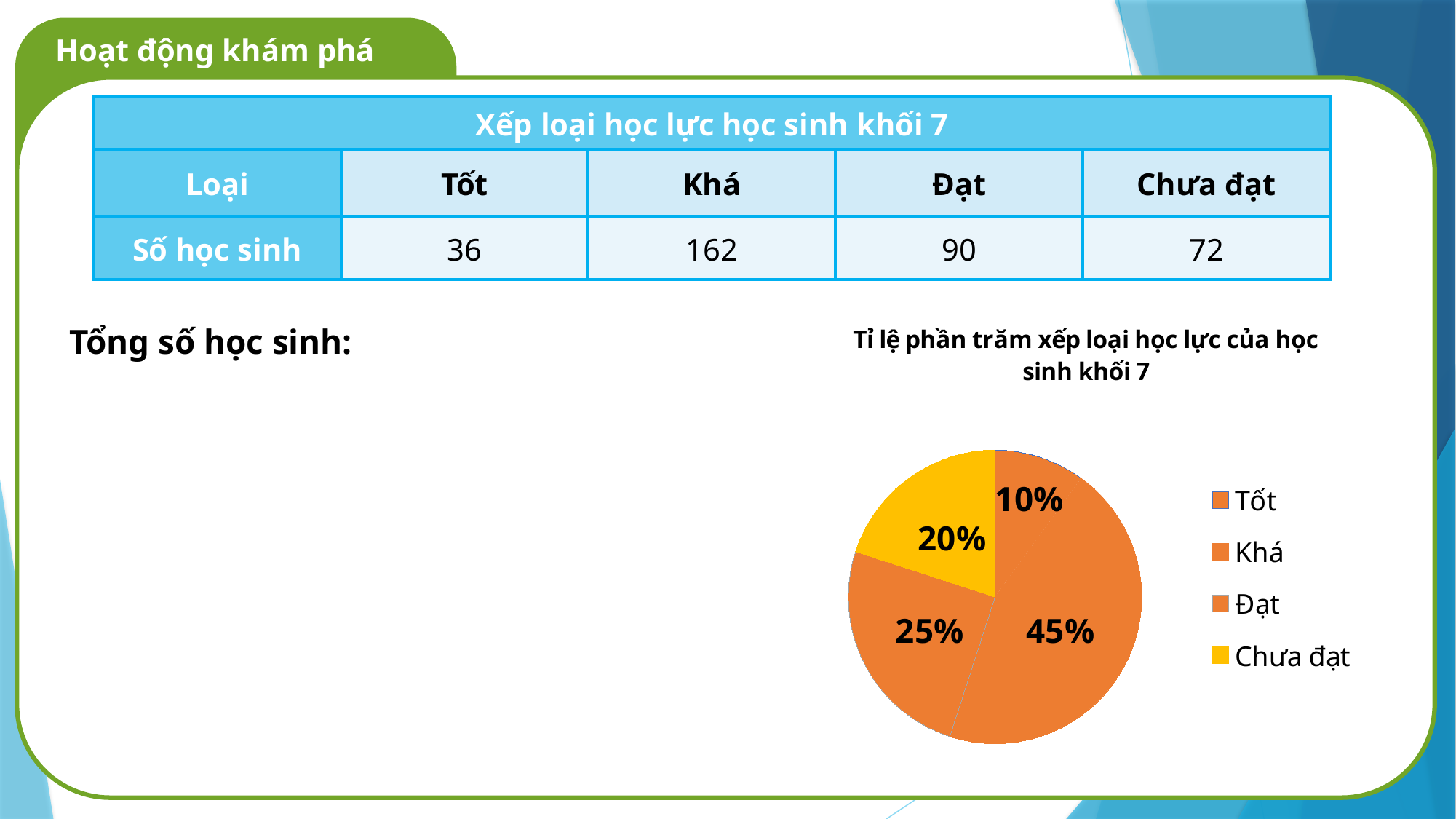
How many categories does the legend of the pie chart list? 4 What is the difference in percentage points between the Khá slice and the Đạt slice in the pie chart? 20% What percentage of the pie chart is the Đạt slice? 25% What is the title of the pie chart? Tỉ lệ phần trăm xếp loại học lực của học sinh khối 7 What type of chart is shown on the slide? pie chart In the pie chart, which slice is larger: Đạt or Chưa đạt? Đạt What percentage of the pie chart is the Chưa đạt slice? 20% Which category has the smallest slice in the pie chart? Tốt What percentage of the pie chart is the Khá slice? 45% Which category has the largest slice in the pie chart? Khá Which category is shown in yellow in the pie chart? Chưa đạt What percentage of the pie chart is the Tốt slice? 10%